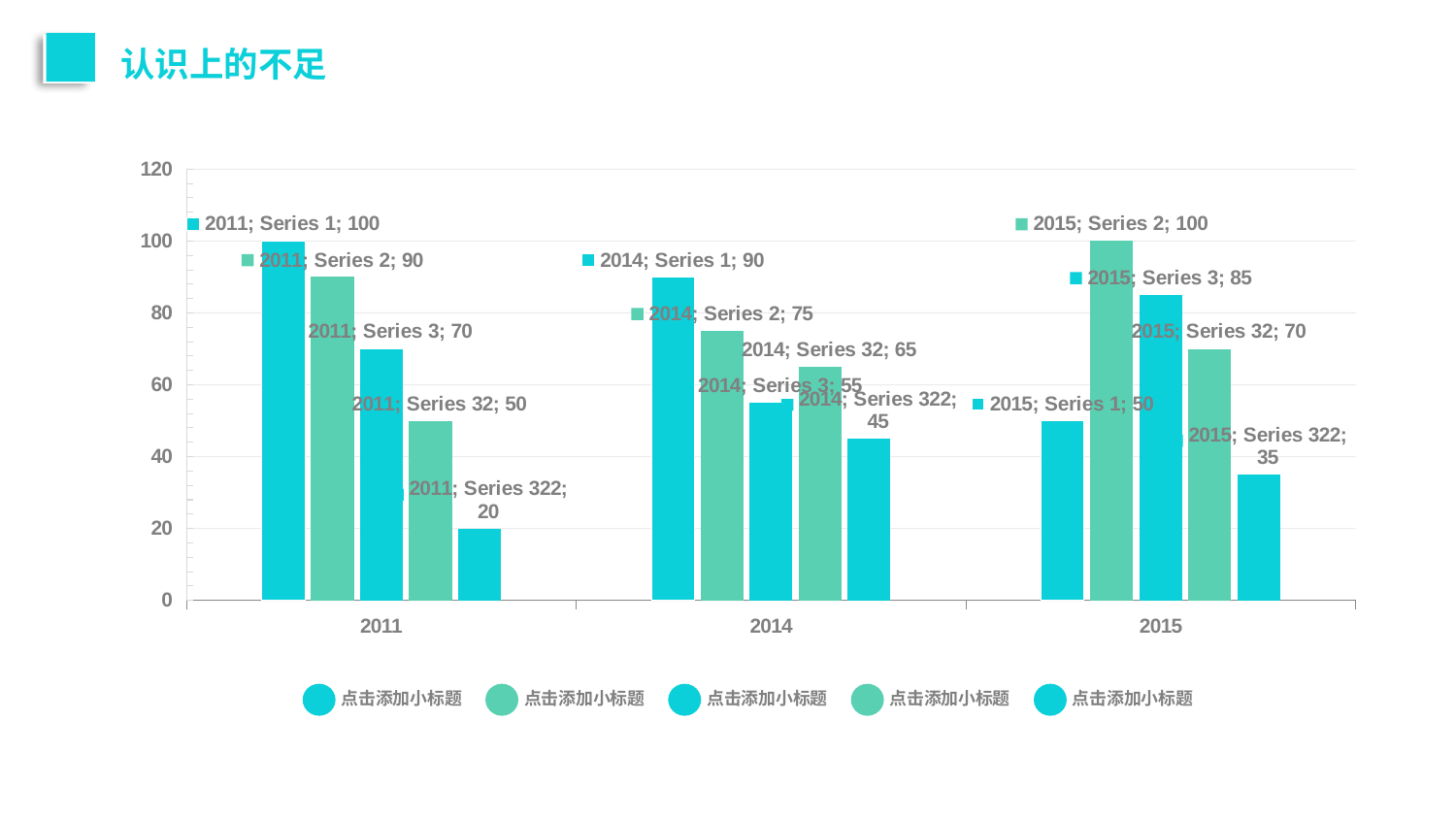
How many categories are shown on the x axis? 3 Which series has the lowest value in 2011? Series 322 Which is larger in 2014: Series 3 or Series 32? Series 32 What kind of chart is shown on the slide? Bar chart What is the value for Series 322 in 2014? 45 What is the value for Series 1 in 2011? 100 What is the difference between Series 1 and Series 322 in 2011? 80 What is the value for Series 3 in 2015? 85 Does the value for Series 1 rise or fall from 2011 to 2015? Fall What is the difference between Series 2 and Series 3 in 2014? 20 Which series has the highest value in 2015? Series 2